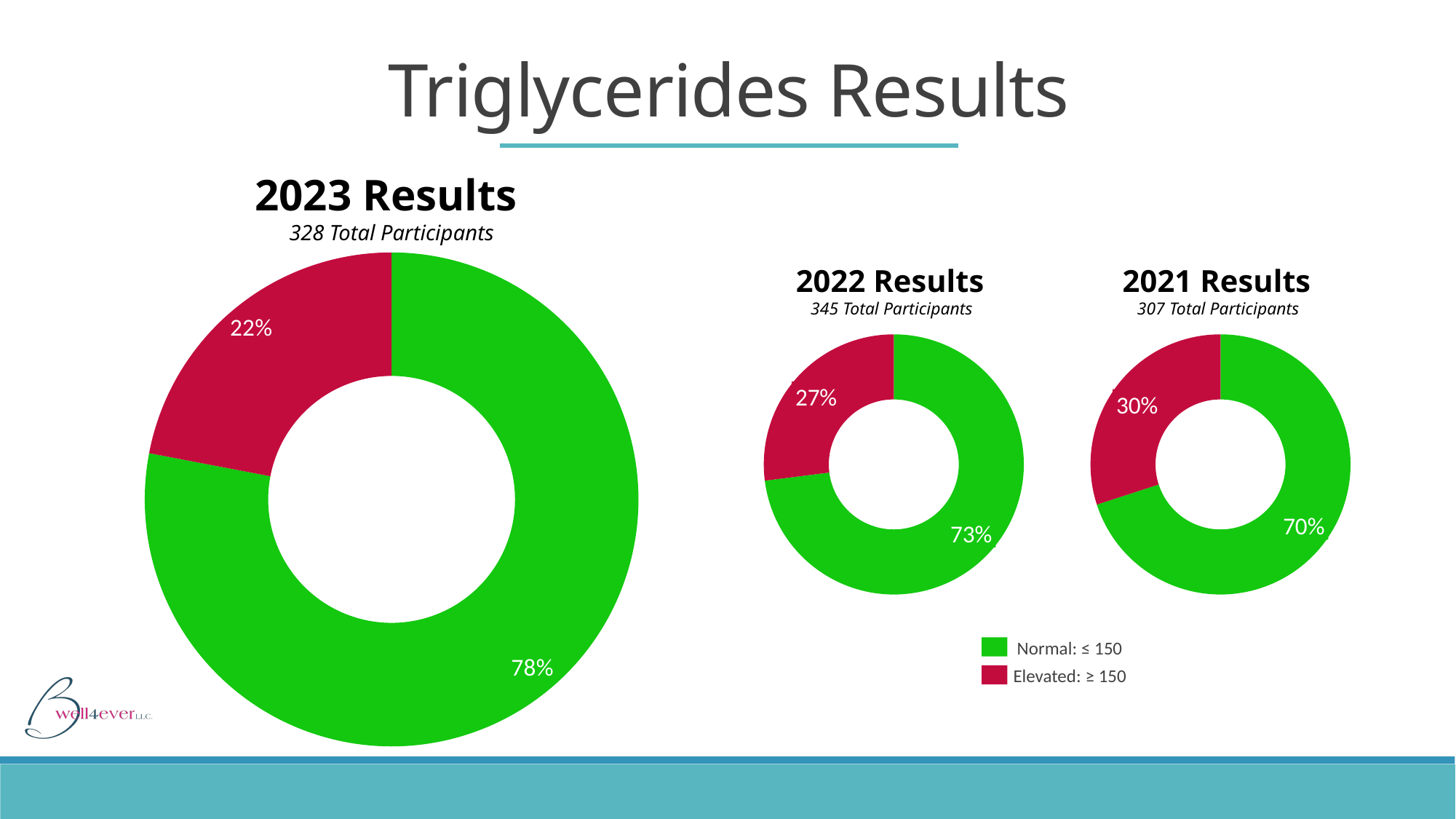
How many entries does the legend list? 2 In the 2023 Results chart, what percentage of participants had Elevated triglycerides? 22% In the 2022 Results chart, what share of participants had Normal triglycerides? 73% How many total participants are shown for the 2022 Results chart? 345 Total Participants In the 2021 Results chart, which slice is larger, Normal or Elevated? Normal Across the three charts, which year has the lowest Elevated percentage? 2023 What kind of chart is used for the 2023 Results? Doughnut chart Across the three charts, which year has the highest Elevated percentage? 2021 In the 2023 Results chart, what percentage of participants had Normal triglycerides? 78% In the 2021 Results chart, what share of participants had Elevated triglycerides? 30% In the 2022 Results chart, what is the difference between the Normal and Elevated percentages? 46% How many slices does the 2022 Results chart have? 2